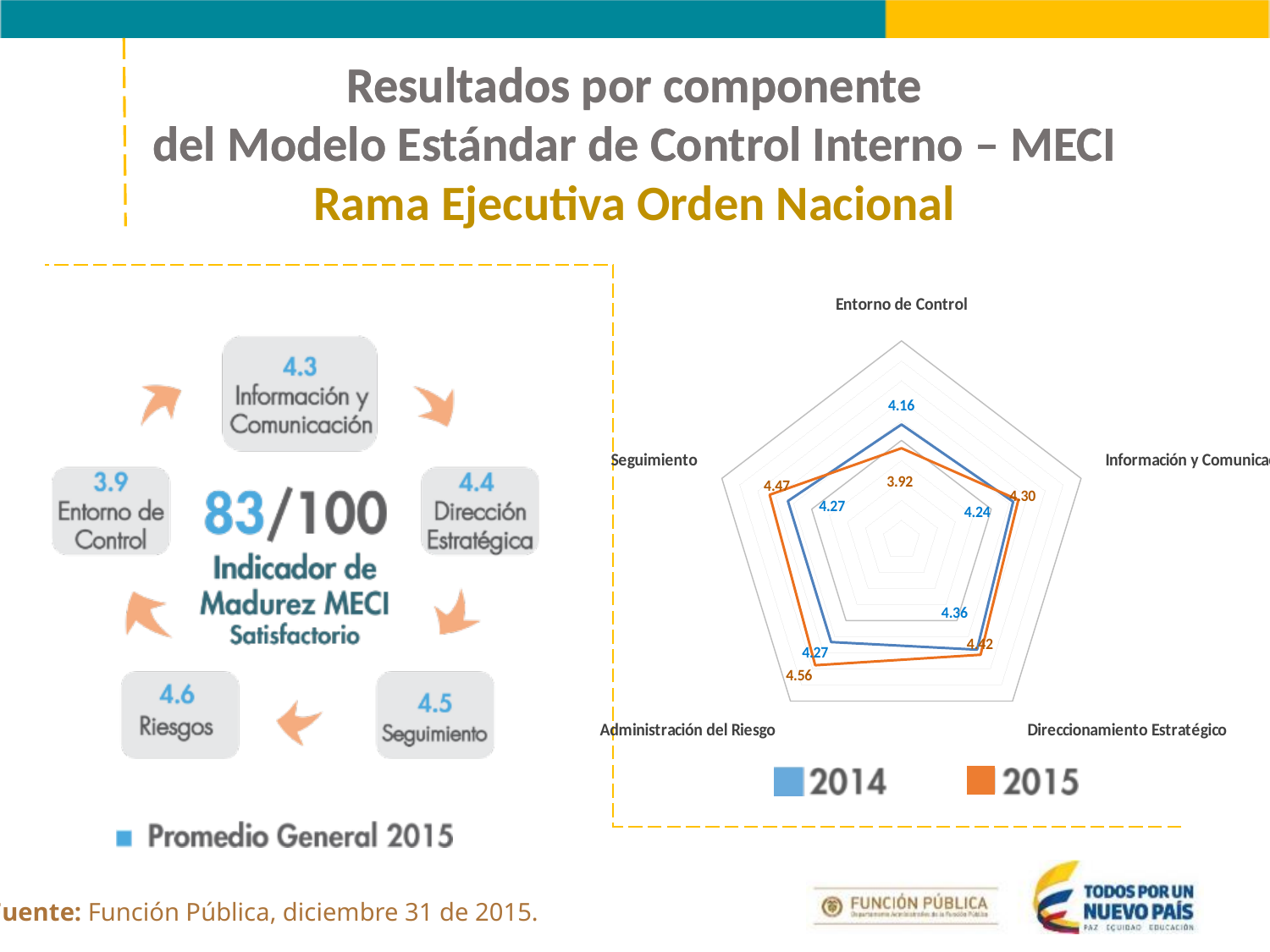
What kind of chart is shown on the right side of the slide? Radar chart How many components (axes) does the radar chart have? 5 In the radar chart, what is the 2015 value for Seguimiento? 4.47 In the radar chart, by how much did Administración del Riesgo increase from 2014 to 2015? 0.29 How many series does the legend of the radar chart list? 2 In the radar chart, what is the 2014 value for Entorno de Control? 4.16 In the radar chart, what is the 2014 value for Administración del Riesgo? 4.27 In the radar chart, what is the 2015 value for Entorno de Control? 3.92 In the radar chart, which year has the higher value for Entorno de Control, 2014 or 2015? 2014 In the radar chart, which component has the highest 2015 value? Administración del Riesgo In the radar chart, what is the 2015 value for Administración del Riesgo? 4.56 In the radar chart, what is the 2014 value for Información y Comunicación? 4.24